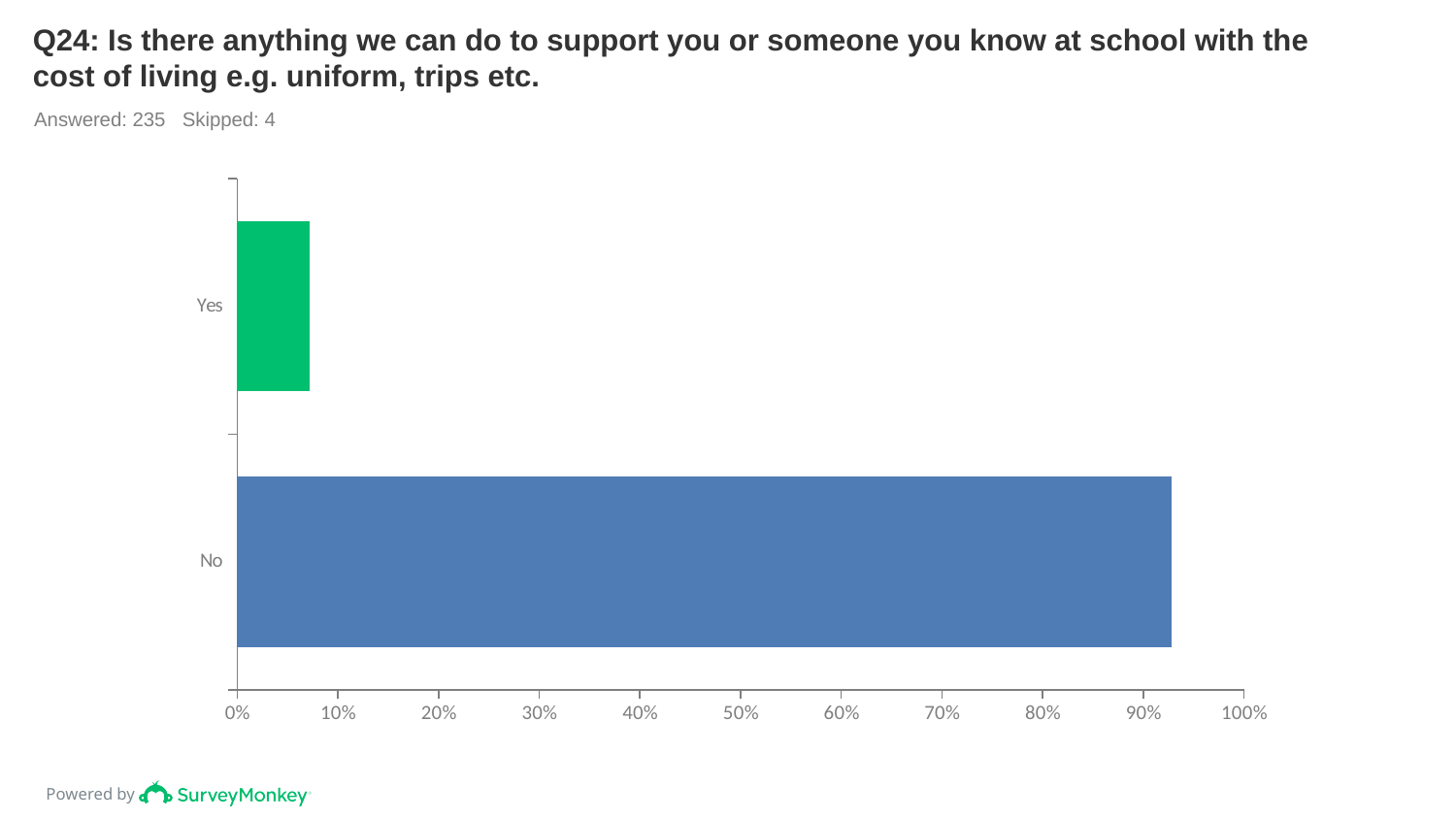
What colour is the bar for Yes? green How many categories are plotted in the chart? 2 Which is larger, the value for Yes or the value for No? No What is the maximum value shown on the x axis? 100% What kind of chart is shown on the slide? bar chart Is the value for No greater or less than 50%? greater Is the value for Yes greater or less than 10%? less Which category has the lowest value? Yes Which category has the highest value? No Is the value for No greater or less than 90%? greater